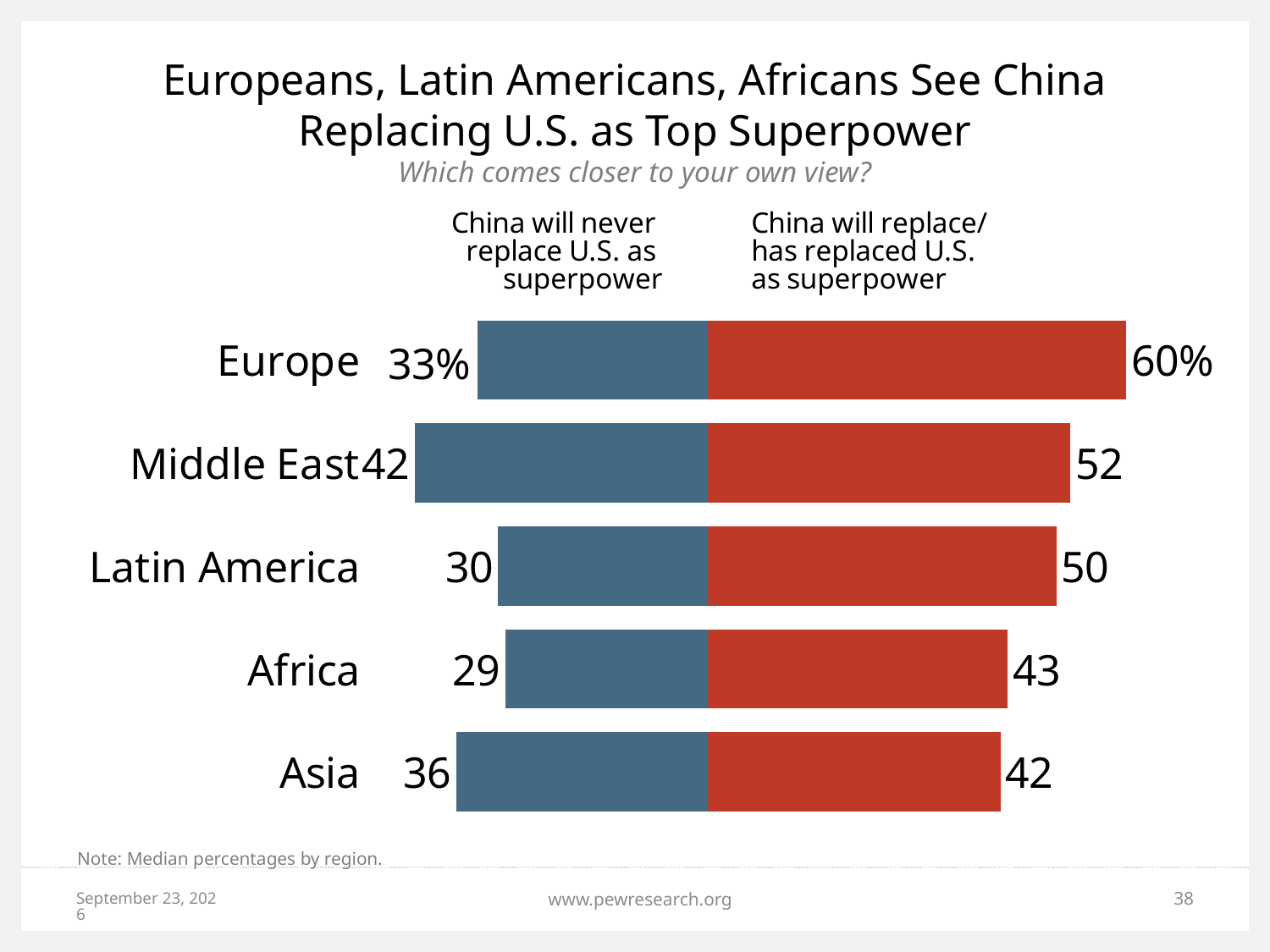
Which is larger: the Middle East's value for 'China will never replace U.S. as superpower' or Latin America's value for the same series? Middle East What is the difference between the two values shown for Europe? 27 What is the value for Asia for 'China will never replace U.S. as superpower'? 36 Which region has the highest value for 'China will replace/has replaced U.S. as superpower'? Europe How many regions are shown in the chart? 5 What is the value for Africa for 'China will replace/has replaced U.S. as superpower'? 43 What is the value for the Middle East for 'China will never replace U.S. as superpower'? 42 How many series does the chart show? 2 What kind of chart is shown on the slide? Bar chart What is the difference between Latin America's and Asia's values for 'China will replace/has replaced U.S. as superpower'? 8 What percentage of Europeans say China will replace/has replaced the U.S. as superpower? 60% Which region has the lowest value for 'China will never replace U.S. as superpower'? Africa